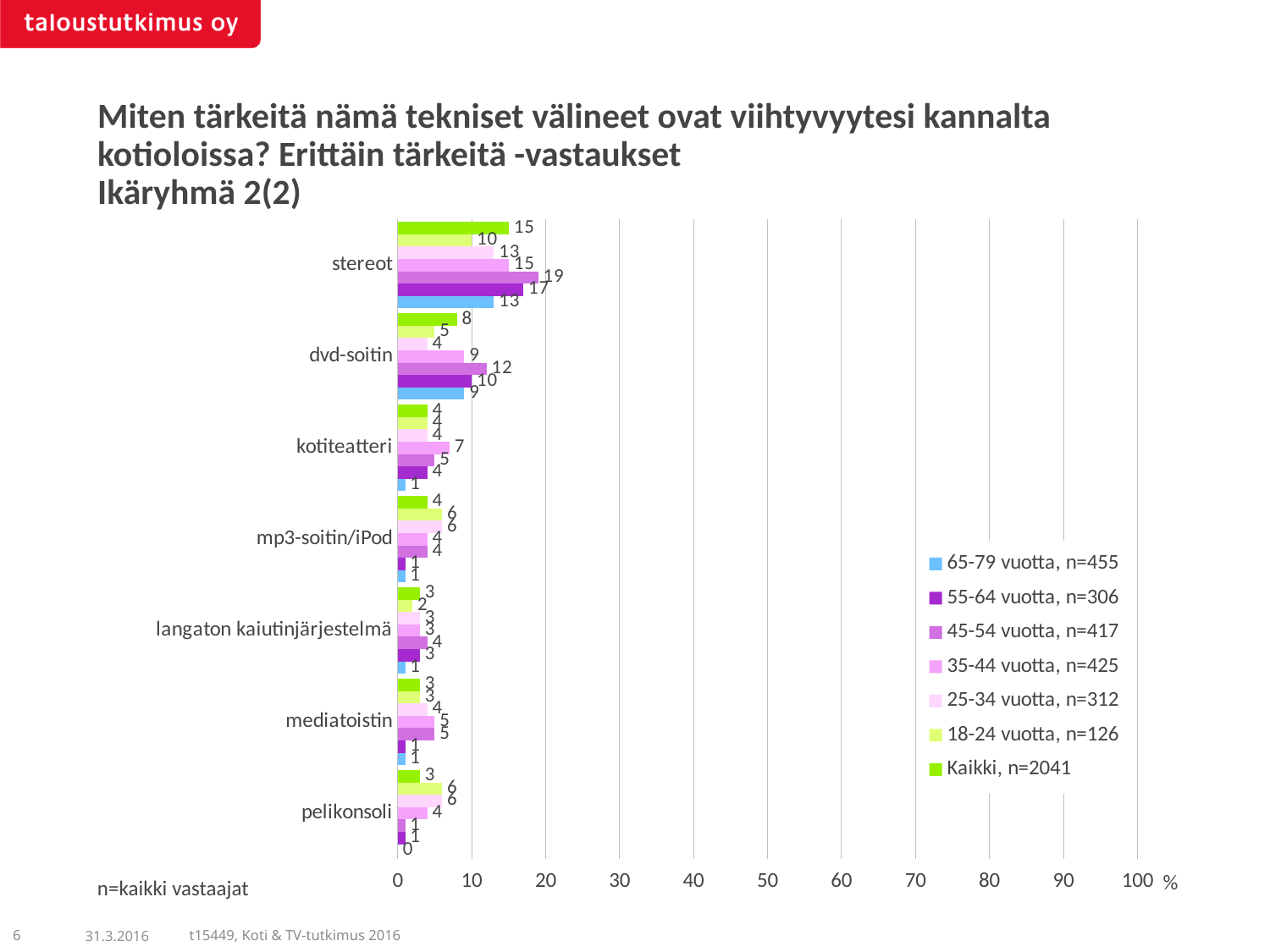
What is the sample size (n) shown in the legend for the Kaikki series? 2041 What is the value for pelikonsoli in the 65-79 vuotta, n=455 series? 0 What type of chart is shown on the slide? bar chart How many categories (devices) are shown on the chart? 7 Which is larger for pelikonsoli: the 18-24 vuotta value or the 35-44 vuotta value? 18-24 vuotta How many series does the legend list? 7 Which category has the highest value in the Kaikki, n=2041 series? stereot What is the value for dvd-soitin in the 45-54 vuotta, n=417 series? 12 Is the value for stereot in the 55-64 vuotta series greater or less than 20? less What is the difference between the 45-54 vuotta and 18-24 vuotta values for stereot? 9 Which age group has the highest value for stereot? 45-54 vuotta, n=417 What is the value for stereot in the Kaikki, n=2041 series? 15